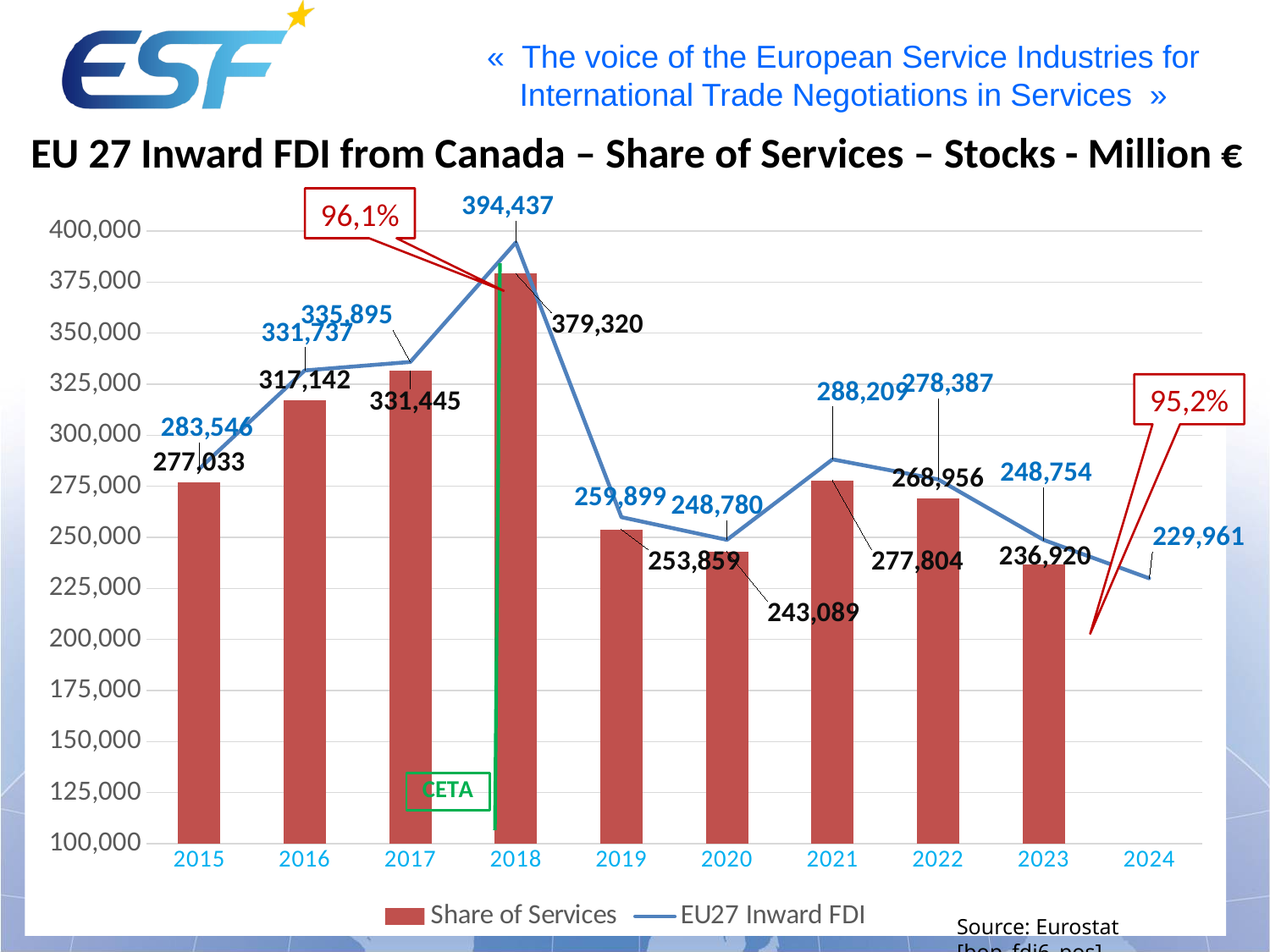
In which year is the Share of Services bar highest? 2018 What is the difference between EU27 Inward FDI and Share of Services in 2018? 15,117 What is the Share of Services value for 2018? 379,320 What is the EU27 Inward FDI value for 2015? 283,546 Which year has the larger Share of Services value, 2016 or 2017? 2017 In which year is the Share of Services bar lowest? 2023 How many series does the legend list? 2 What kind of chart is shown on the slide? A combined bar and line chart How many Share of Services bars are plotted? 9 What is the EU27 Inward FDI value for 2024? 229,961 What label is shown in the green box near the 2018 bar? CETA Does the EU27 Inward FDI line rise or fall from 2021 to 2024? Fall